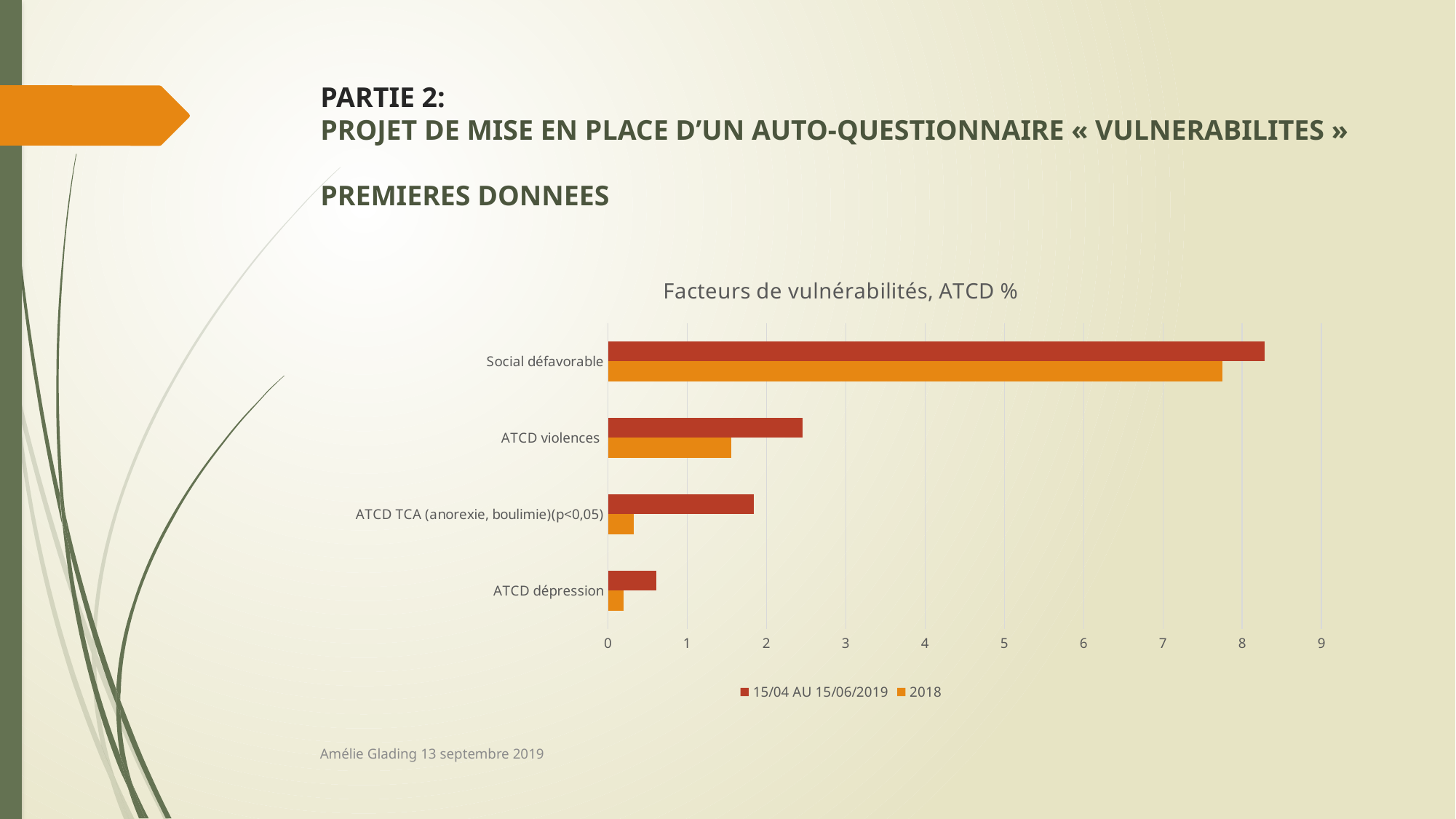
Is the value for ATCD TCA (anorexie, boulimie)(p<0,05) in the 2018 series greater or less than 1? less Is the value for Social défavorable in the 2018 series greater or less than 8? less Which category has the lowest value for the 2018 series? ATCD dépression Is the value for Social défavorable in the 15/04 AU 15/06/2019 series greater or less than 8? greater Which series is shown in orange in the legend? 2018 For ATCD TCA (anorexie, boulimie)(p<0,05), which series has the larger value: 15/04 AU 15/06/2019 or 2018? 15/04 AU 15/06/2019 How many categories are shown on the chart? 4 What type of chart is shown on the slide? Bar chart How many series does the chart legend list? 2 Which category has the highest value for the 15/04 AU 15/06/2019 series? Social défavorable What is the title of the chart? Facteurs de vulnérabilités, ATCD %